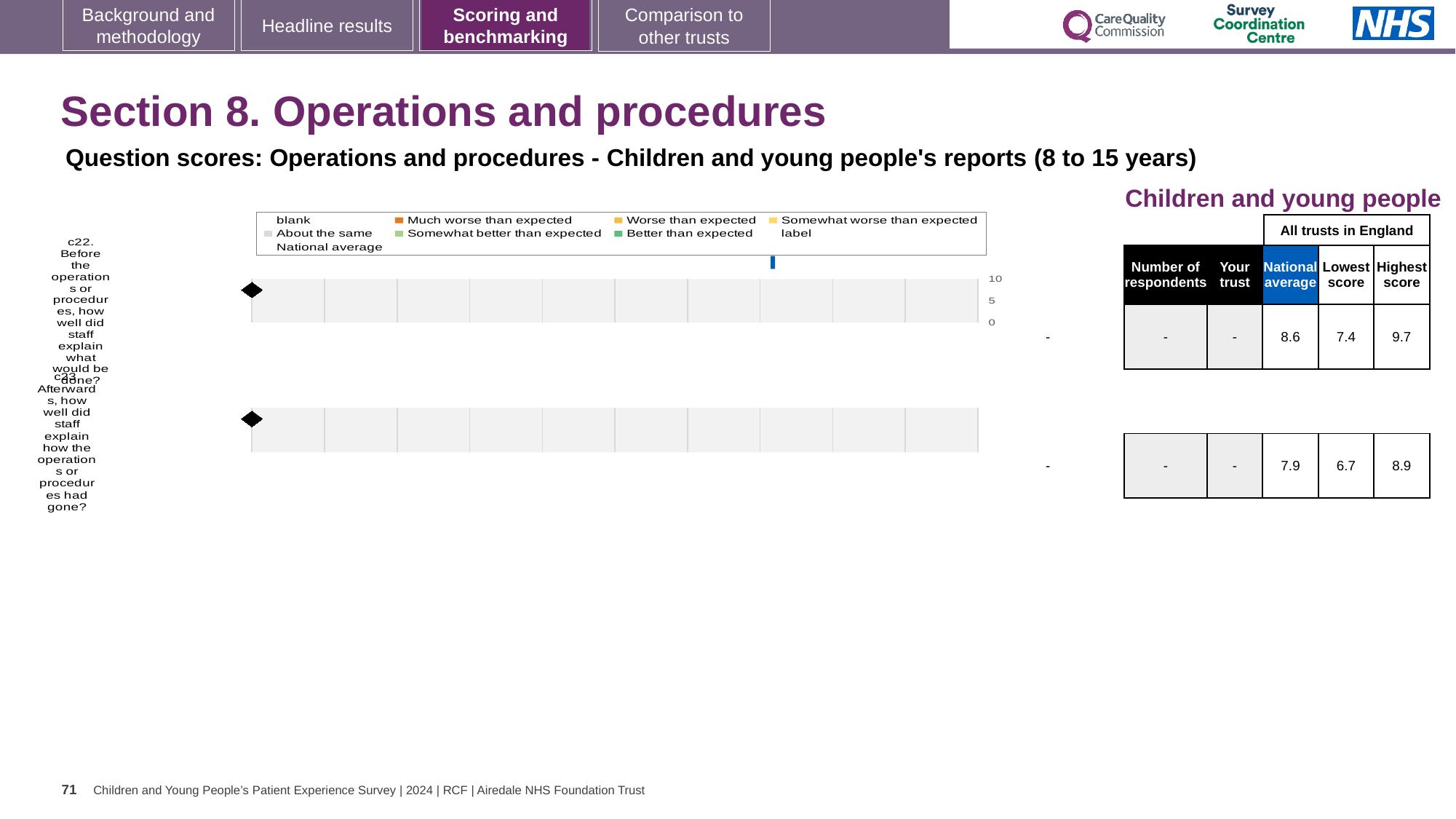
In the table beside the chart, what is the difference between the Highest score and the Lowest score for c22? 2.3 Which legend entry is shown in orange? Much worse than expected In the table beside the chart, what is the National average for c22 (Before the operations or procedures, how well did staff explain what would be done?)? 8.6 What is the highest value shown on the chart's axis? 10 In the table beside the chart, what is the Highest score for c23? 8.9 In the table beside the chart, what is the Lowest score for c22? 7.4 How many questions (categories) are plotted on the chart? 2 In the table beside the chart, what is the Highest score for c22? 9.7 In the table beside the chart, what is the National average for c23 (Afterwards, how well did staff explain how the operations or procedures had gone?)? 7.9 What kind of chart is shown on the slide? Bar chart In the table beside the chart, what is the Lowest score for c23? 6.7 In the table beside the chart, which question has the higher National average, c22 or c23? c22